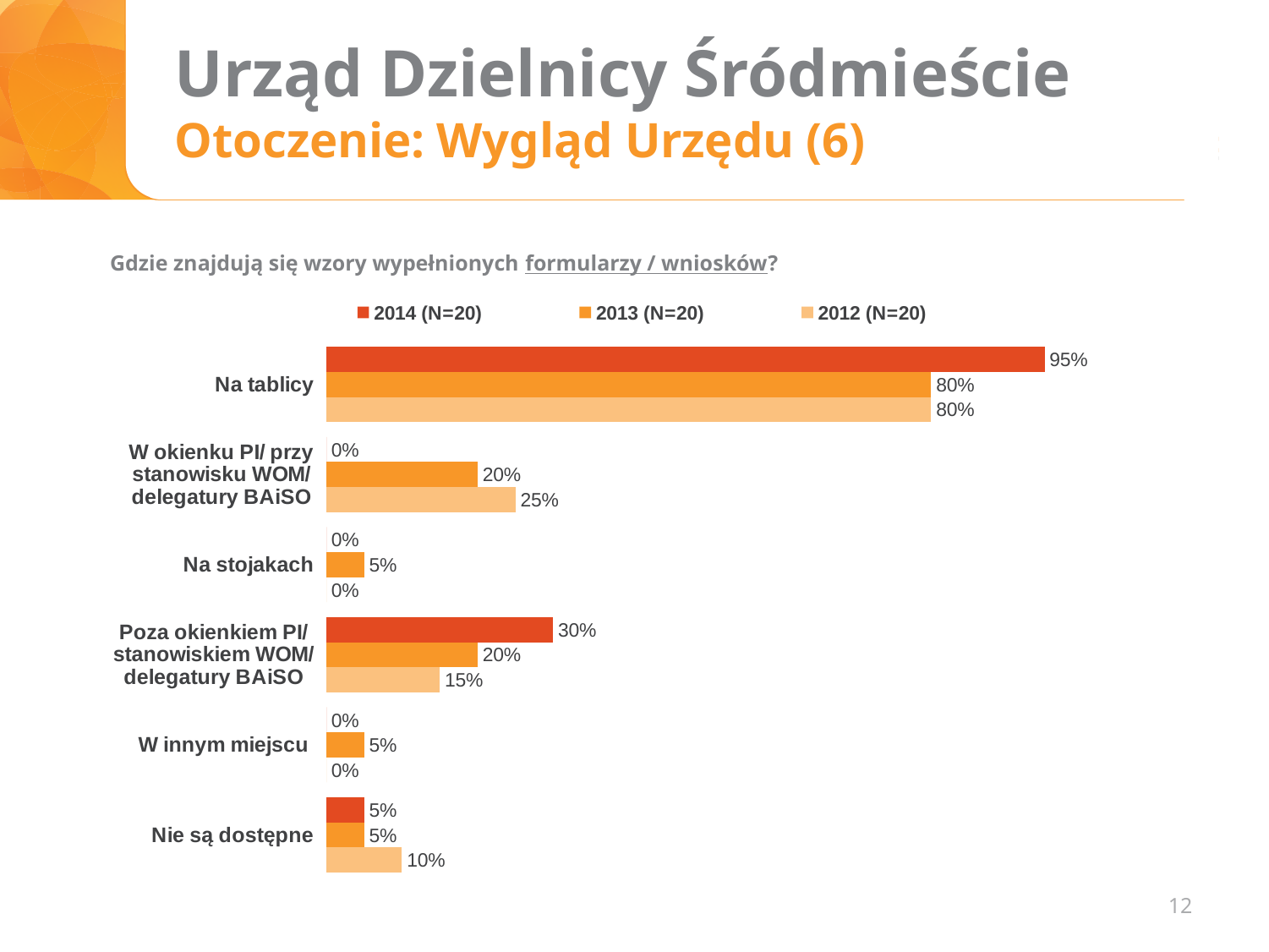
What is the value for "Nie są dostępne" in the 2012 (N=20) series? 10% For "Poza okienkiem PI/ stanowiskiem WOM/ delegatury BAiSO", which series has the larger value: 2014 (N=20) or 2012 (N=20)? 2014 (N=20) Which category has the highest value in the 2012 (N=20) series? Na tablicy What kind of chart is shown on the slide? Bar chart What is the difference between the 2012 (N=20) and 2013 (N=20) values for "W okienku PI/ przy stanowisku WOM/ delegatury BAiSO"? 5% What is the difference between the 2014 (N=20) and 2013 (N=20) values for "Na tablicy"? 15% How many series does the legend list? 3 Which category has the highest value in the 2014 (N=20) series? Na tablicy How many categories are shown on the chart? 6 What is the value for "Na tablicy" in the 2014 (N=20) series? 95% What is the value for "W okienku PI/ przy stanowisku WOM/ delegatury BAiSO" in the 2013 (N=20) series? 20% What is the value for "Poza okienkiem PI/ stanowiskiem WOM/ delegatury BAiSO" in the 2012 (N=20) series? 15%